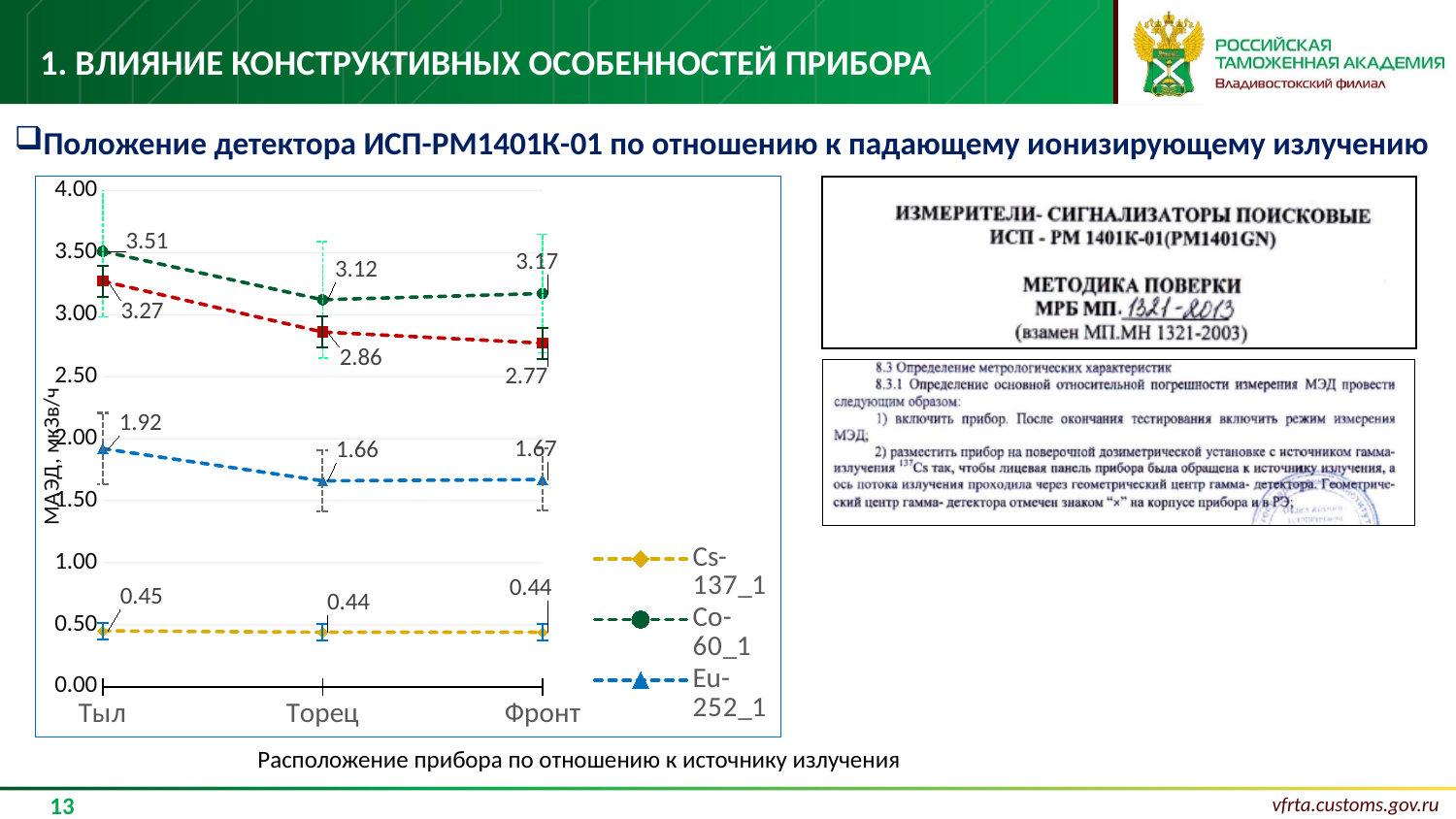
What is the difference between the Co-60_1 values at Тыл and Торец? 0.39 Which is larger at Тыл: the value for Co-60_1 or the value for Eu-252_1? Co-60_1 What is the value for Co-60_1 at Тыл? 3.51 How many series does the legend list? 3 How many positions are shown on the x axis? 3 Is the value for Eu-252_1 at Тыл greater or less than 1.50? greater What is the label of the y axis? МАЭД, мкЗв/ч What is the value for Eu-252_1 at Торец? 1.66 At which position does Co-60_1 have its highest value? Тыл What is the value for Cs-137_1 at Фронт? 0.44 At which position does Co-60_1 have its lowest value? Торец What kind of chart is shown on the slide? line chart